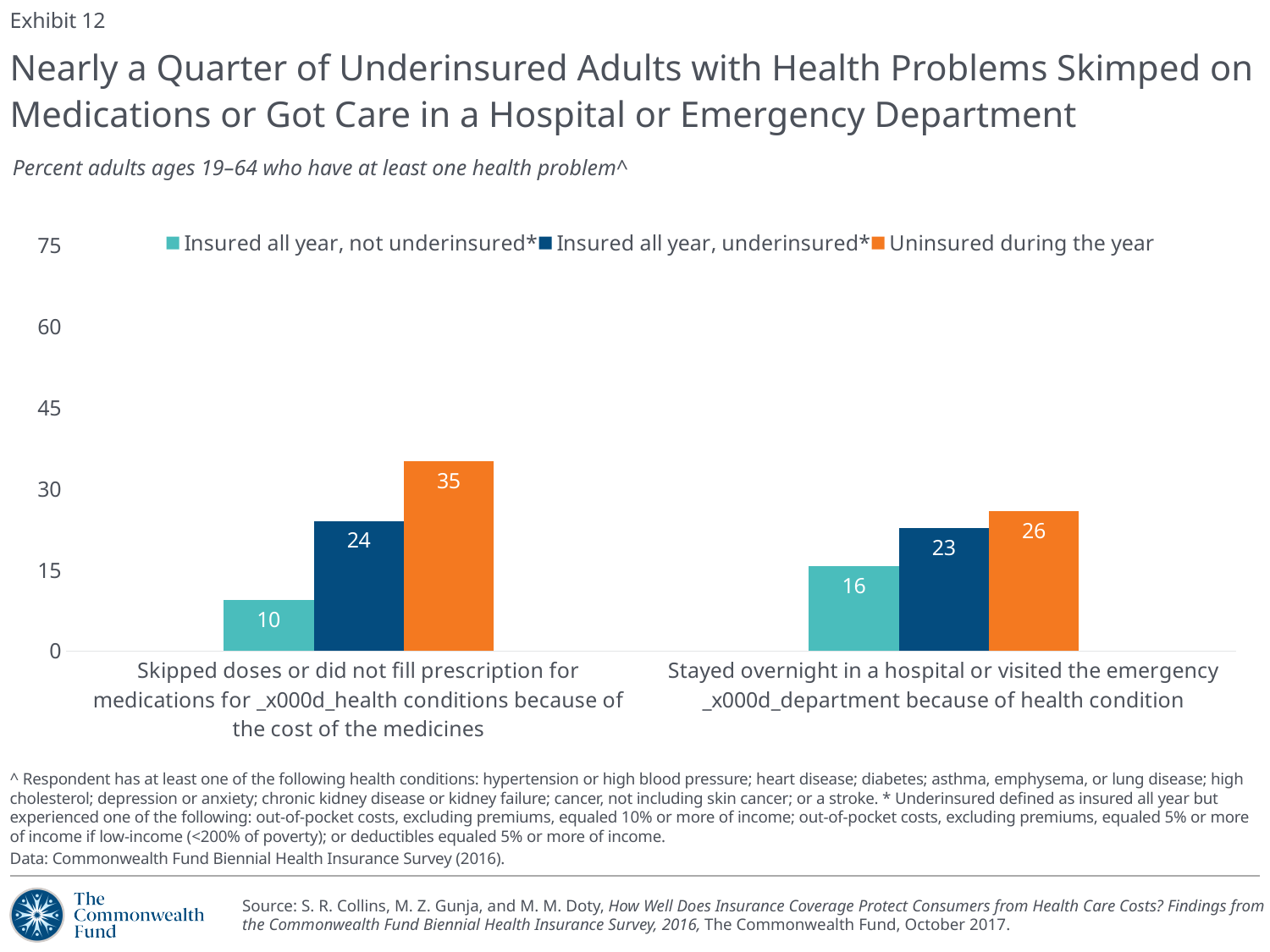
What is the value for "Insured all year, not underinsured*" in the "Skipped doses or did not fill prescription for medications" category? 10 How many categories are shown on the x axis? 2 What is the value for "Uninsured during the year" in the "Stayed overnight in a hospital or visited the emergency department" category? 26 What is the value for "Insured all year, underinsured*" in the "Skipped doses or did not fill prescription for medications" category? 24 How many series does the legend list? 3 Is the value for "Uninsured during the year" in the "Skipped doses" category greater or less than 30? greater Which series has the highest value in the "Skipped doses or did not fill prescription for medications" category? Uninsured during the year What is the difference between the "Insured all year, underinsured*" values for the two categories? 1 Which series has the lowest value in the "Stayed overnight in a hospital or visited the emergency department" category? Insured all year, not underinsured* Which is larger: the "Insured all year, not underinsured*" value for skipping doses or for staying overnight in a hospital? Staying overnight in a hospital (16) What is the difference between the "Uninsured during the year" and "Insured all year, not underinsured*" values in the "Skipped doses or did not fill prescription for medications" category? 25 What kind of chart is shown on the slide? Bar chart